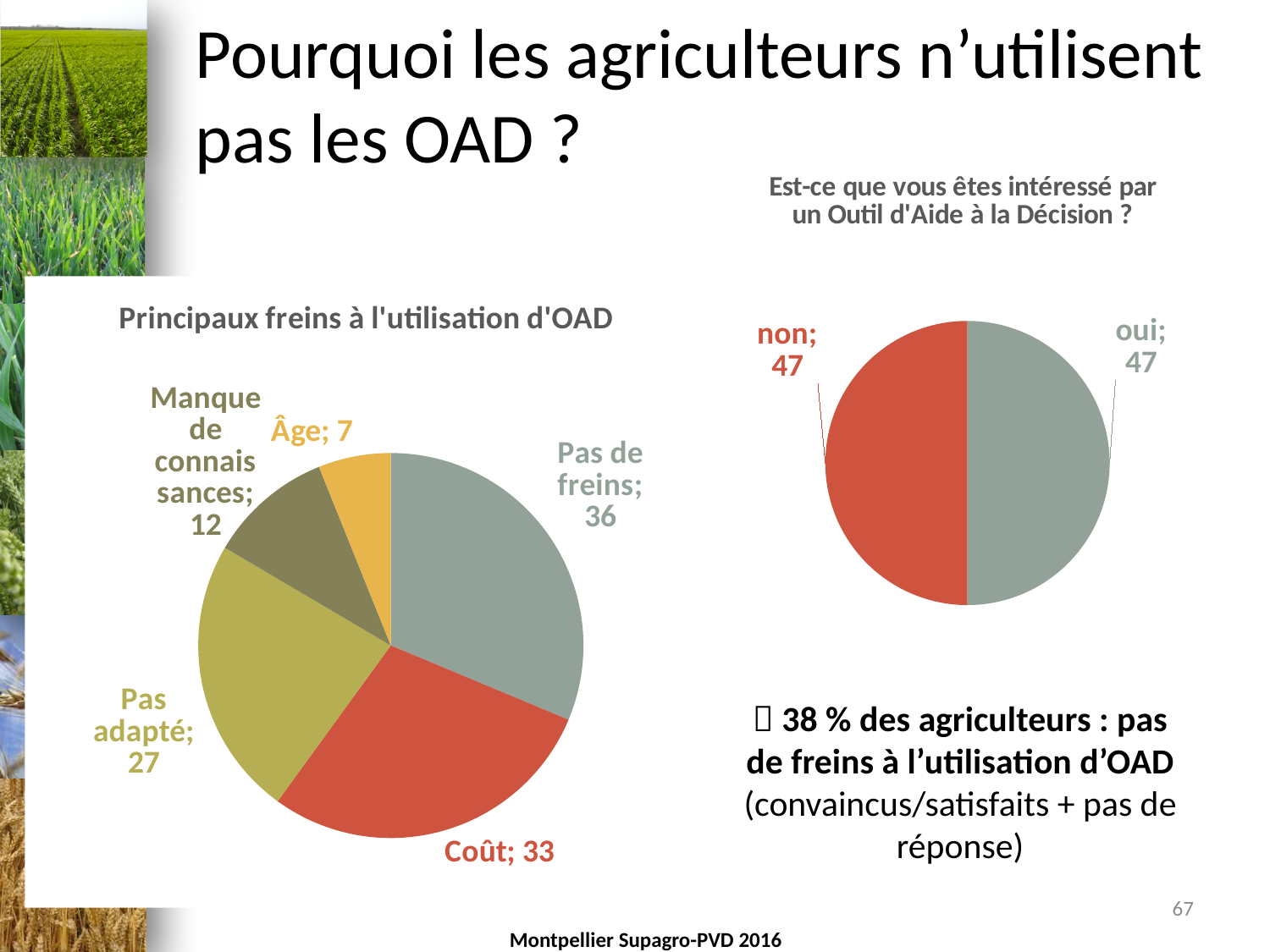
In the 'Est-ce que vous êtes intéressé par un Outil d'Aide à la Décision ?' pie chart, what is the value for 'non'? 47 In the 'Principaux freins à l'utilisation d'OAD' pie chart, what is the difference between 'Pas de freins' and 'Coût'? 3 In the 'Principaux freins à l'utilisation d'OAD' pie chart, what is the value for 'Pas adapté'? 27 In the 'Principaux freins à l'utilisation d'OAD' pie chart, which category has the largest value? Pas de freins How many categories are shown in the 'Principaux freins à l'utilisation d'OAD' pie chart? 5 In the 'Principaux freins à l'utilisation d'OAD' pie chart, which is larger, 'Coût' or 'Pas adapté'? Coût In the 'Principaux freins à l'utilisation d'OAD' pie chart, which category has the smallest value? Âge In the 'Est-ce que vous êtes intéressé par un Outil d'Aide à la Décision ?' pie chart, what is the difference between 'oui' and 'non'? 0 In the 'Principaux freins à l'utilisation d'OAD' pie chart, what is the value for 'Manque de connaissances'? 12 In the 'Principaux freins à l'utilisation d'OAD' pie chart, what is the value for 'Coût'? 33 What type of chart is the chart on the right of the slide? Pie chart In the 'Principaux freins à l'utilisation d'OAD' pie chart, what is the difference between 'Pas adapté' and 'Âge'? 20